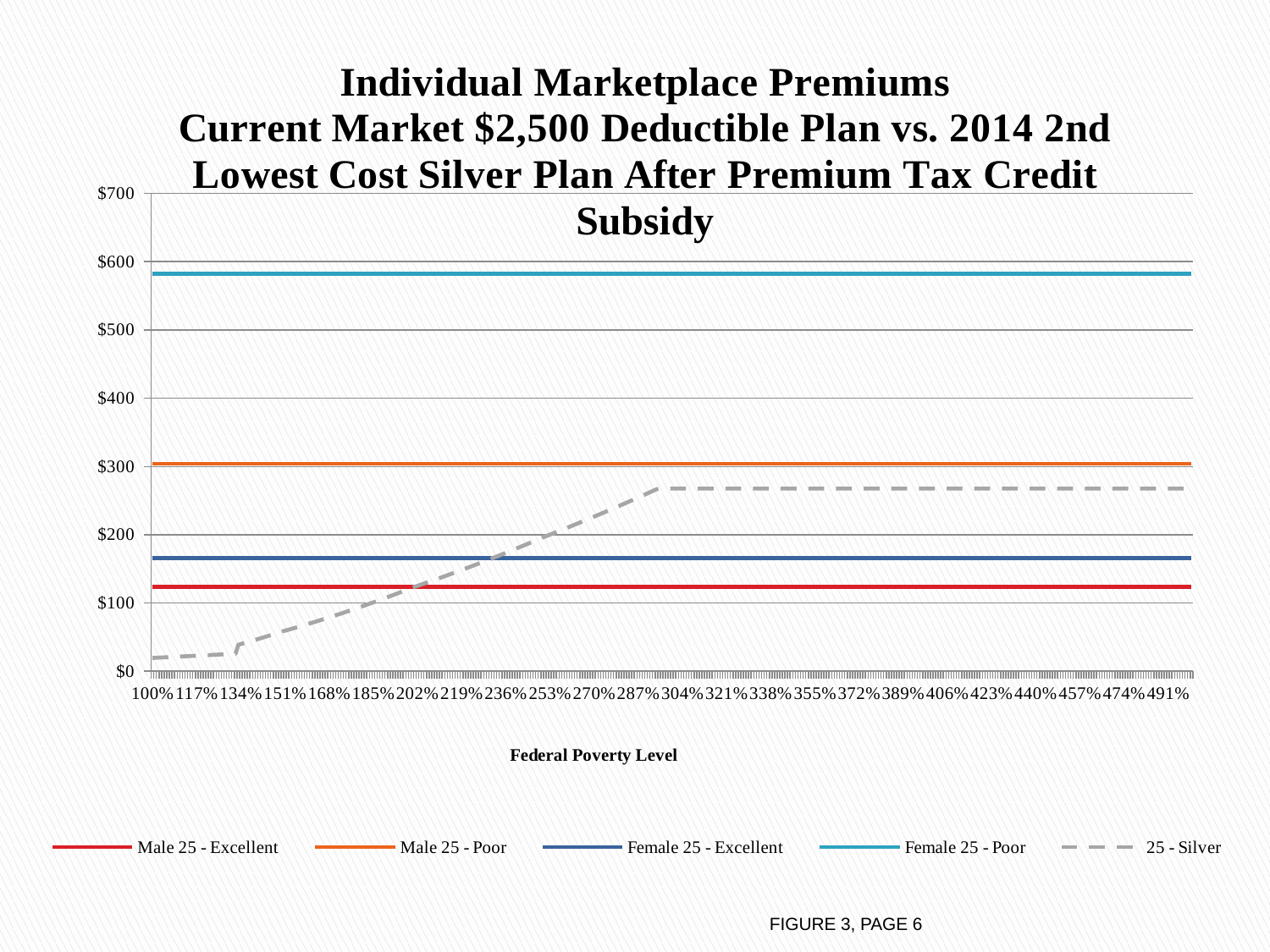
Which series has the highest premium across the chart? Female 25 - Poor What kind of chart is shown on the slide? Line chart How many series does the legend list? 5 Is the value for Female 25 - Excellent greater or less than $200? less Is the value for Male 25 - Poor greater or less than $400? less How does the 25 - Silver series change as the Federal Poverty Level increases? It rises, then levels off and stays flat Is the value for 25 - Silver at 491% Federal Poverty Level greater or less than $200? greater Which is larger, the premium for Male 25 - Poor or for Female 25 - Excellent? Male 25 - Poor Which of the four flat (solid-line) series has the lowest premium? Male 25 - Excellent What is the label of the x axis? Federal Poverty Level